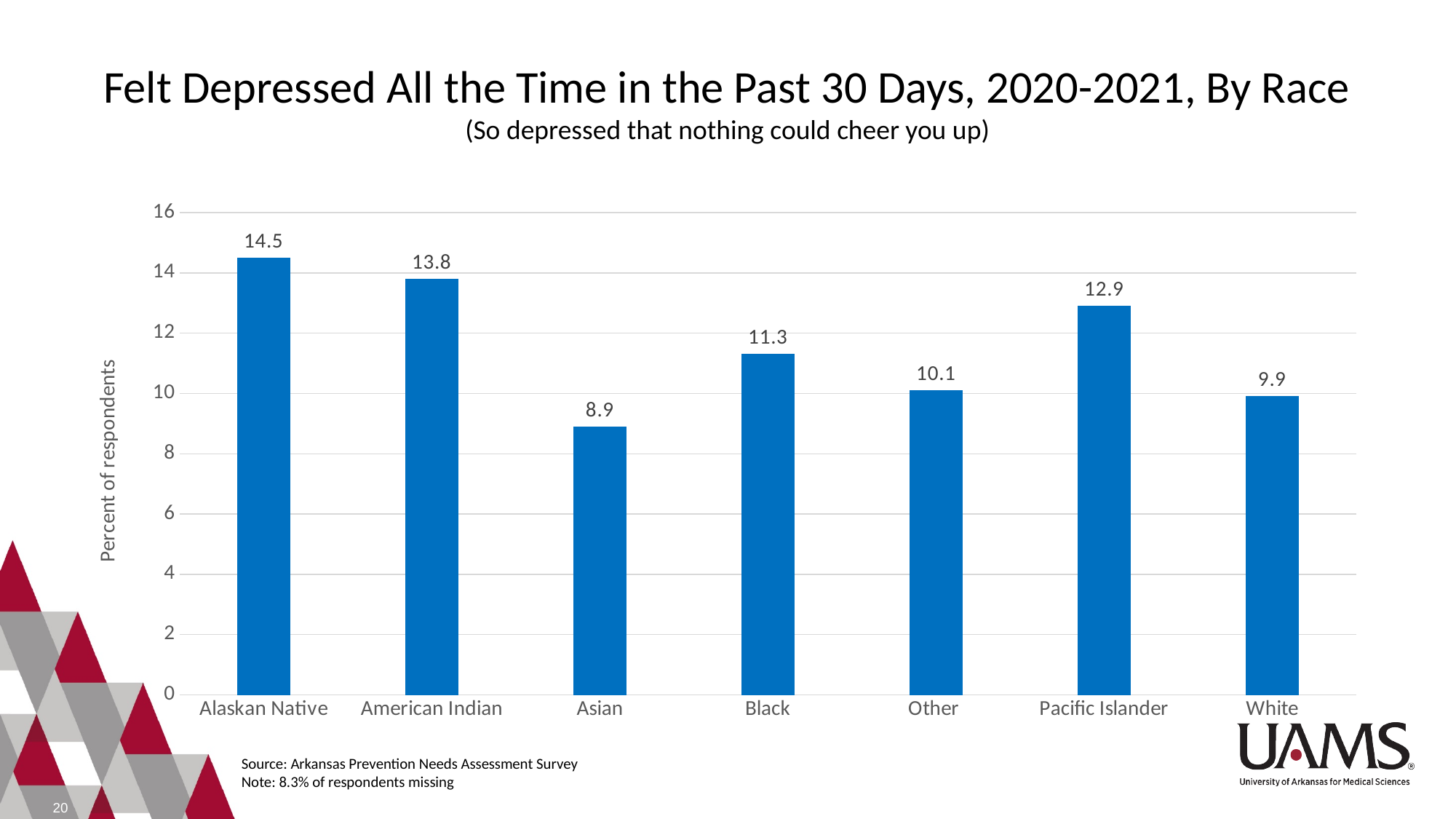
Which race category has the lowest value? Asian What is the label of the vertical axis? Percent of respondents What is the value for Alaskan Native? 14.5 How many race categories are shown on the x axis? 7 What is the difference between the values for Black and Other? 1.2 What is the value for Pacific Islander? 12.9 What is the difference between the values for Alaskan Native and White? 4.6 What is the value for Asian? 8.9 Which is larger, the value for American Indian or the value for Pacific Islander? American Indian Which race category has the highest value? Alaskan Native What kind of chart is shown on the slide? bar chart Is the value for Black greater or less than 12? less